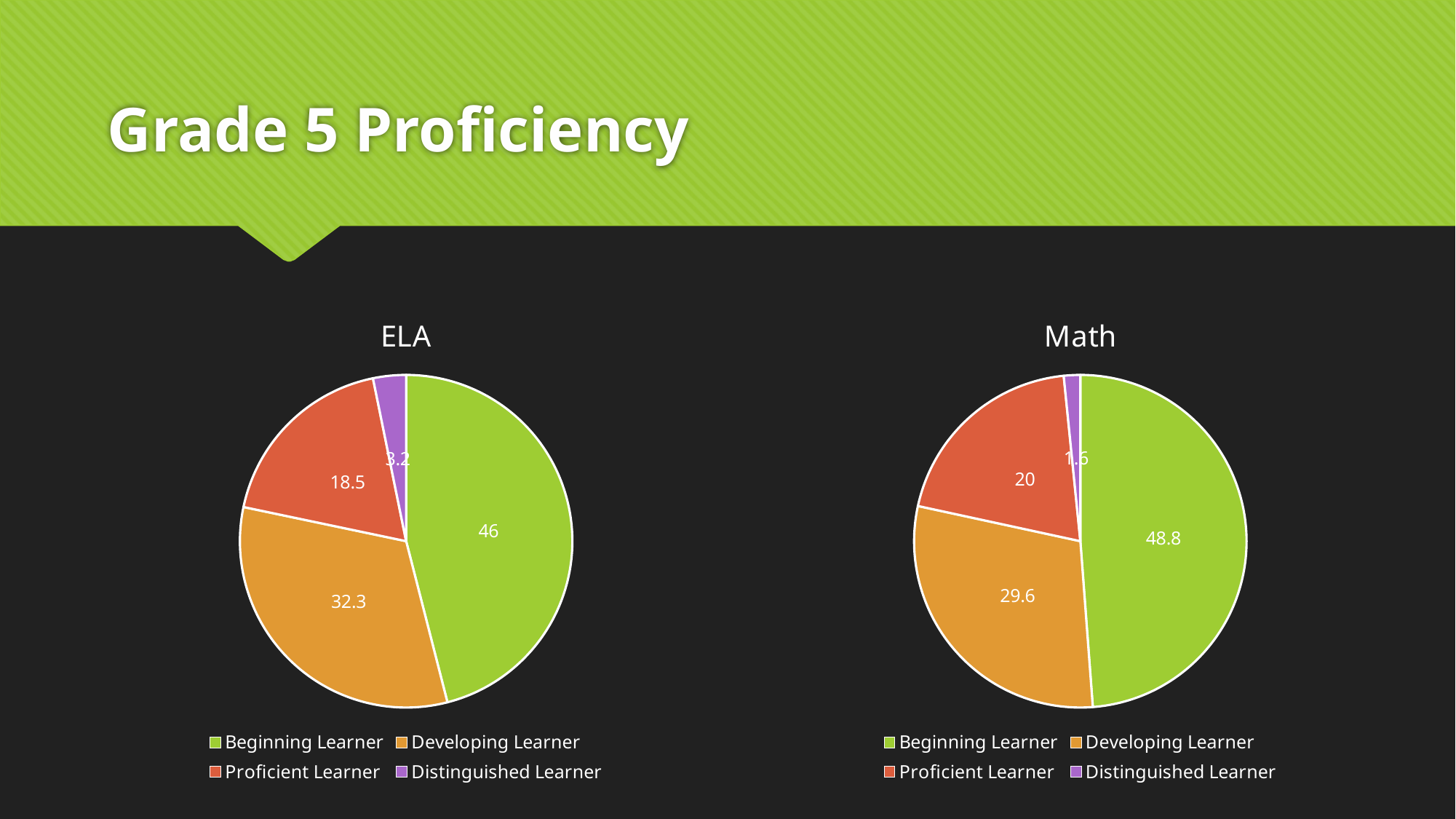
In the ELA chart, which category has the smallest slice? Distinguished Learner In the ELA chart, what is the value for Distinguished Learner? 3.2 Which is larger: the Proficient Learner value in the ELA chart or the Proficient Learner value in the Math chart? Math In the ELA chart, what is the value for Beginning Learner? 46 In the Math chart, which category has the largest slice? Beginning Learner In the Math chart, what is the value for Developing Learner? 29.6 In the ELA chart, what is the difference between the Beginning Learner and Developing Learner values? 13.7 In the ELA chart, what colour is the Developing Learner slice? Orange What kind of chart is the Math chart? Pie chart In the Math chart, what is the value for Proficient Learner? 20 How many categories does the ELA chart show? 4 In the Math chart, what is the difference between the Proficient Learner and Distinguished Learner values? 18.4